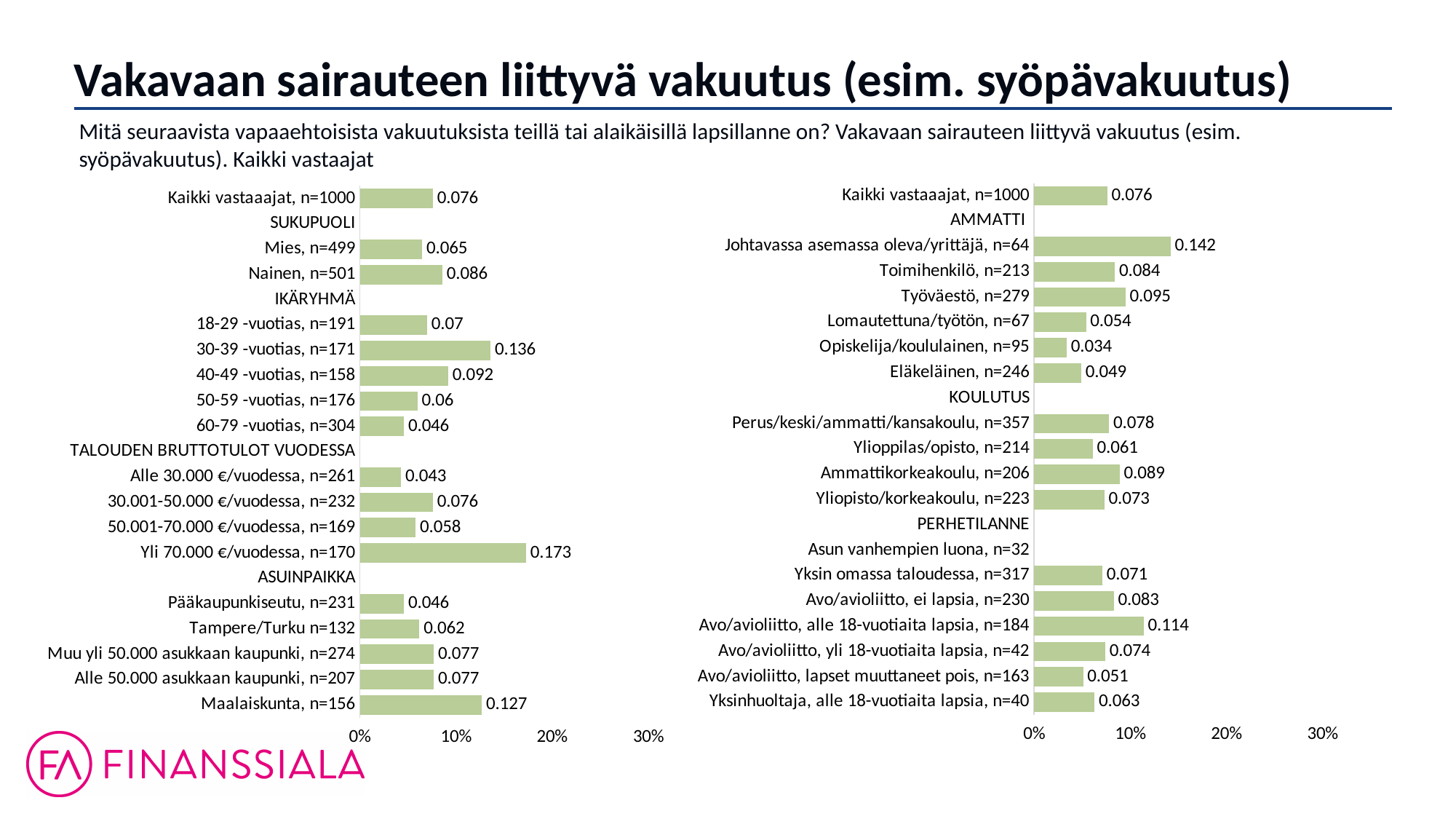
In the right chart, is the value for Avo/avioliitto, alle 18-vuotiaita lapsia, n=184 greater or less than 10%? greater In the left chart, what is the value for Yli 70.000 €/vuodessa, n=170? 0.173 In the right chart, what is the difference between the values for Johtavassa asemassa oleva/yrittäjä, n=64 and Opiskelija/koululainen, n=95? 0.108 In the left chart, what is the value for Maalaiskunta, n=156? 0.127 In the right chart, what is the value for Opiskelija/koululainen, n=95? 0.034 In the left chart, which category has the highest value? Yli 70.000 €/vuodessa, n=170 In the right chart, which category has the highest value? Johtavassa asemassa oleva/yrittäjä, n=64 In the right chart, what is the value for Johtavassa asemassa oleva/yrittäjä, n=64? 0.142 In the left chart, which category has the lowest value? Alle 30.000 €/vuodessa, n=261 What kind of chart is shown on the left side of the slide? bar chart In the left chart, what is the difference between the values for 30-39 -vuotias, n=171 and 18-29 -vuotias, n=191? 0.066 In the left chart, which is larger: the value for Mies, n=499 or Nainen, n=501? Nainen, n=501